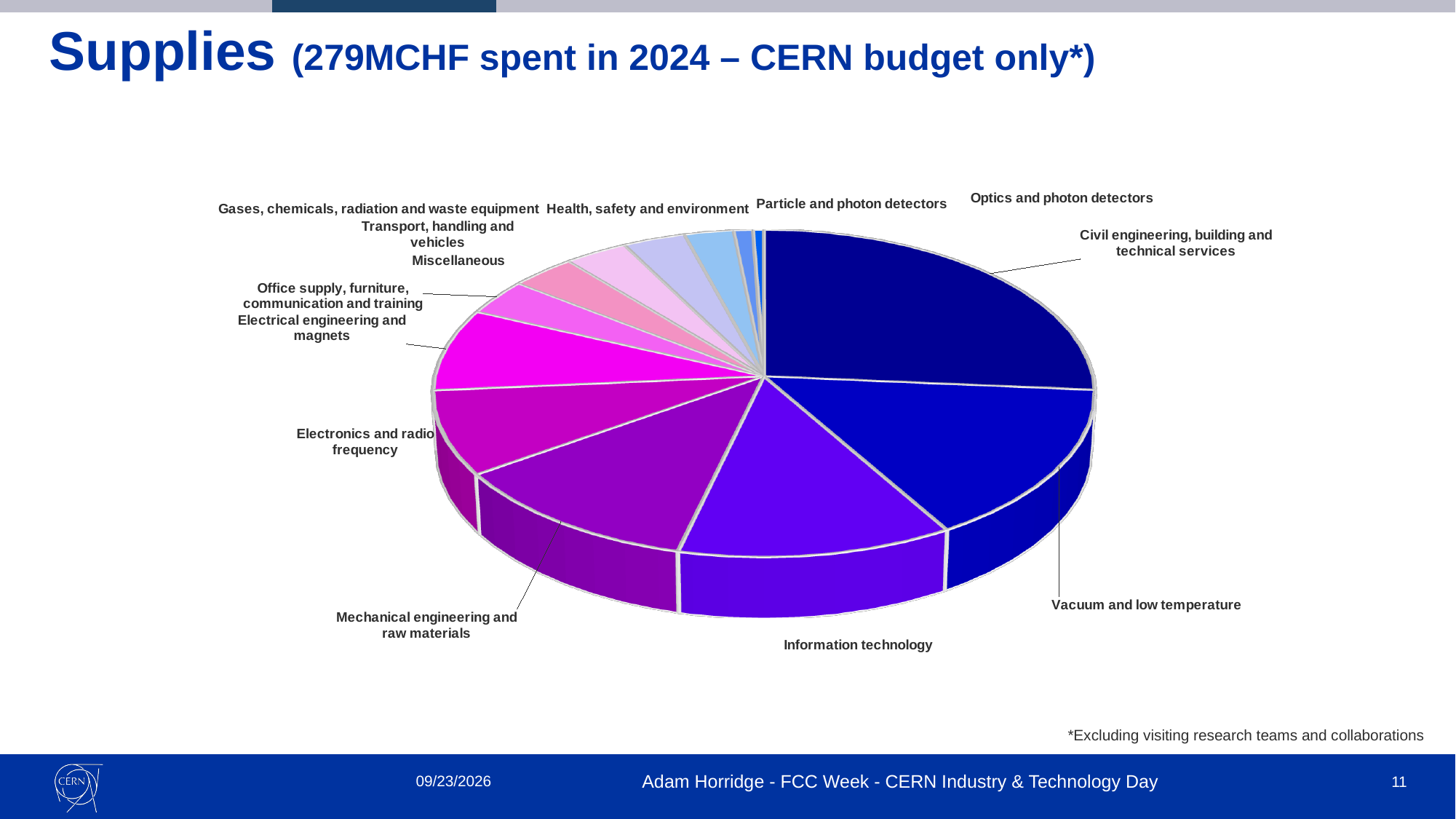
Which slice is larger: Electrical engineering and magnets or Transport, handling and vehicles? Electrical engineering and magnets Which category has the largest slice of the pie chart? Civil engineering, building and technical services Which slice is larger: Mechanical engineering and raw materials or Miscellaneous? Mechanical engineering and raw materials What kind of chart is shown on the slide? Pie chart Which slice is larger: Civil engineering, building and technical services or Information technology? Civil engineering, building and technical services How many categories (slices) does the pie chart have? 13 What does the footnote say is excluded from the supplies figure? Visiting research teams and collaborations According to the slide title, how much was spent on supplies in 2024? 279MCHF